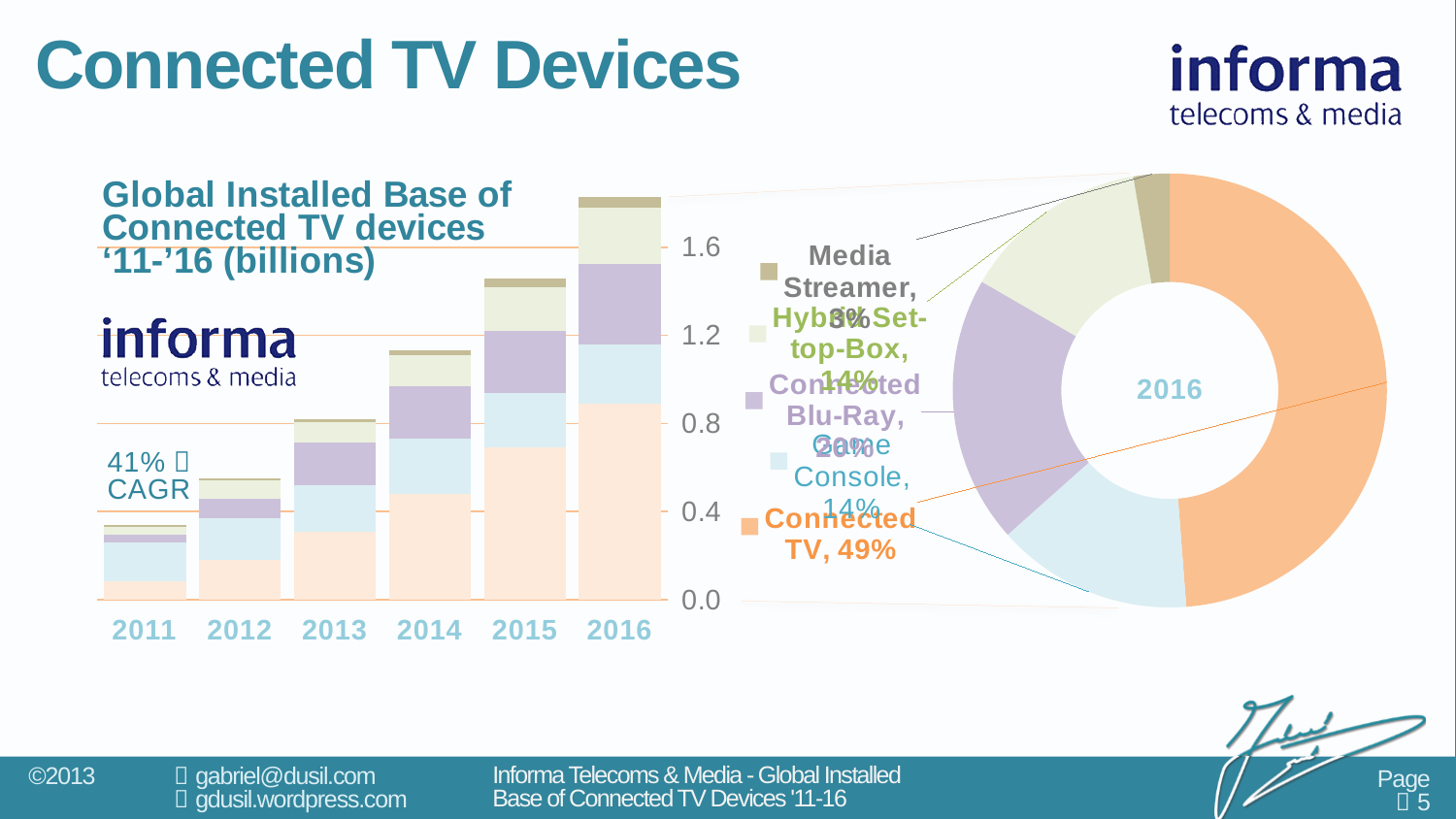
What kind of chart is the 'Global Installed Base of Connected TV devices' chart on the left of the slide? Bar chart In the 'Global Installed Base of Connected TV devices' bar chart, do the total bar heights rise or fall from 2011 to 2016? Rise In the 'Global Installed Base of Connected TV devices' bar chart, which year has the shortest stacked bar? 2011 In the 2016 donut chart on the right, which device category has the smallest share? Media Streamer In the 'Global Installed Base of Connected TV devices' bar chart, which year has the tallest stacked bar? 2016 In the 'Global Installed Base of Connected TV devices' bar chart, how many years are shown on the x axis? 6 In the 2016 donut chart on the right, what share does Connected Blu-Ray have? 20% In the 'Global Installed Base of Connected TV devices' bar chart, is the total value for 2016 greater or less than 1.6? greater In the 'Global Installed Base of Connected TV devices' bar chart, is the total value for 2015 greater or less than 1.2? greater In the 2016 donut chart on the right, what share does Connected TV have? 49% In the 2016 donut chart on the right, which device category has the largest share? Connected TV In the 'Global Installed Base of Connected TV devices' bar chart, is the total value for 2011 greater or less than 0.4? less